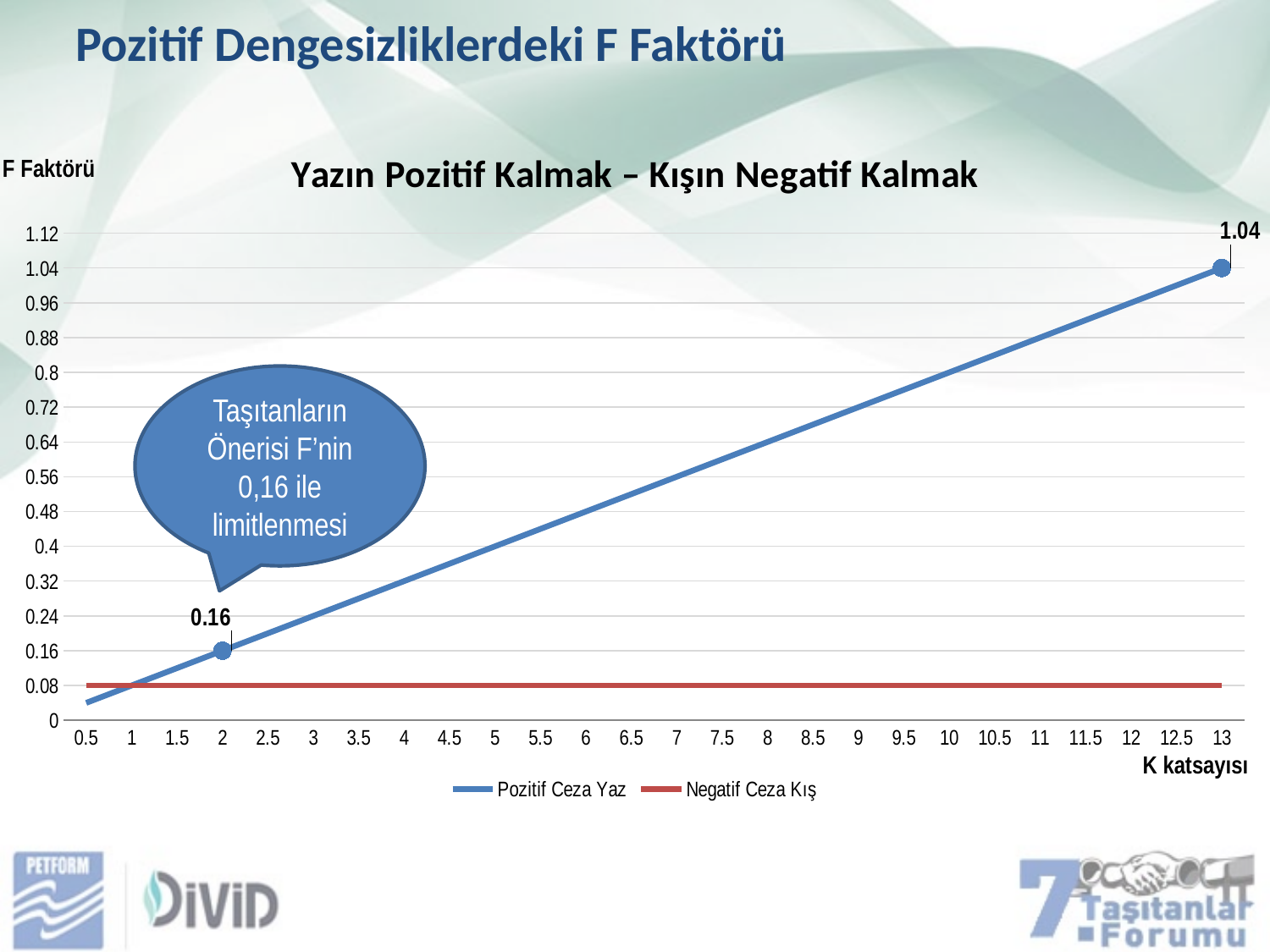
What is the label of the x axis? K katsayısı What kind of chart is shown on the slide? Line chart Is the value of Pozitif Ceza Yaz at K katsayısı 7 greater or less than 0.4? greater What is the difference between the Pozitif Ceza Yaz values at K katsayısı 13 and K katsayısı 2? 0.88 At K katsayısı 13, which series has the higher value, Pozitif Ceza Yaz or Negatif Ceza Kış? Pozitif Ceza Yaz What is the value of the Pozitif Ceza Yaz series at K katsayısı 13? 1.04 Does the Negatif Ceza Kış line rise, fall or stay flat as K katsayısı increases? Stays flat What is the title of the chart? Yazın Pozitif Kalmak – Kışın Negatif Kalmak How many series does the legend list? 2 Is the value of Pozitif Ceza Yaz at K katsayısı 4 greater or less than 0.4? less Does the Pozitif Ceza Yaz line rise or fall as K katsayısı increases? Rises What is the value of the Pozitif Ceza Yaz series at K katsayısı 2? 0.16